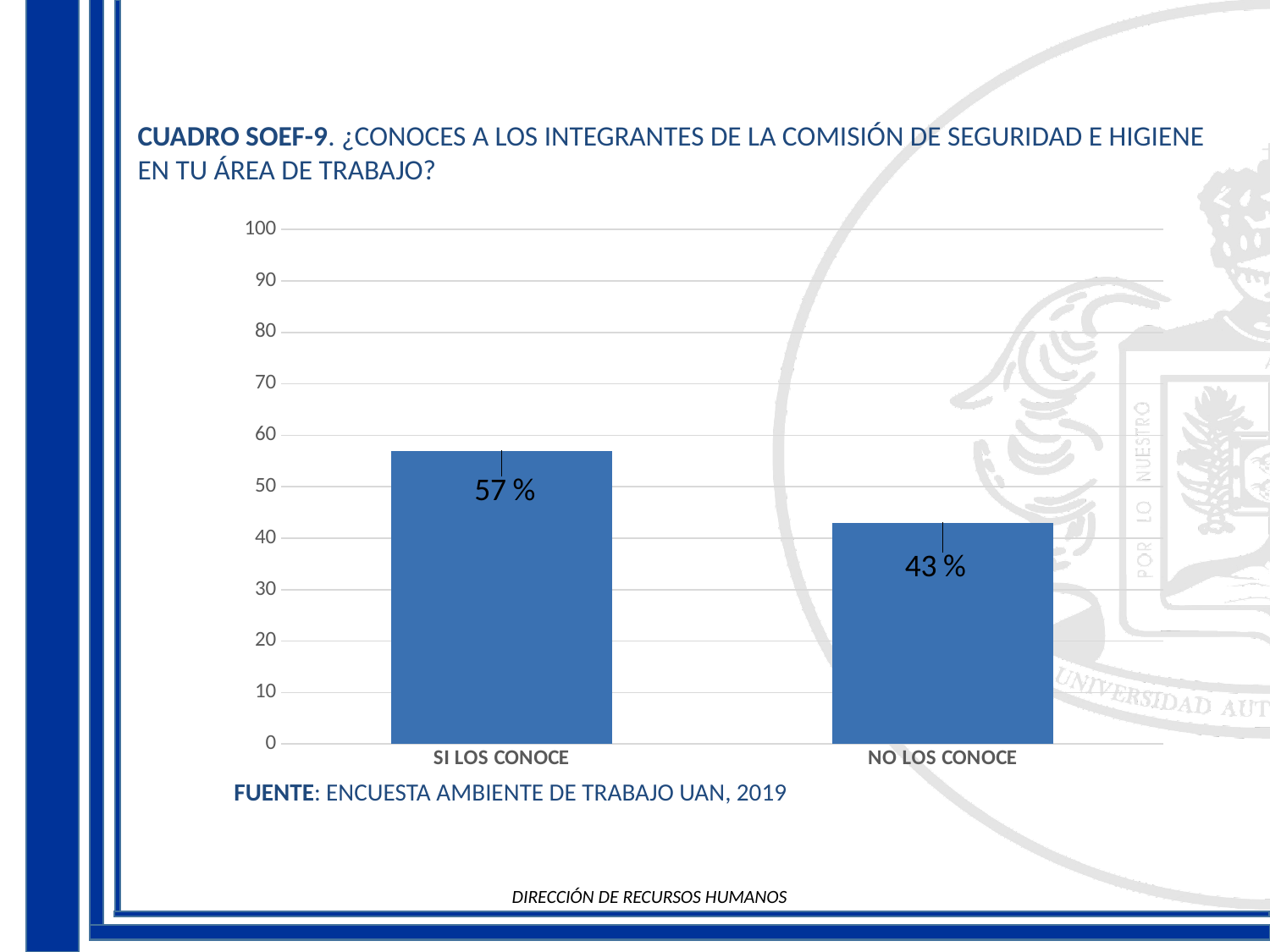
What is the maximum value shown on the vertical axis? 100 Which is larger, the value for SI LOS CONOCE or NO LOS CONOCE? SI LOS CONOCE Which category has the lowest value? NO LOS CONOCE Is the value for SI LOS CONOCE greater or less than 50? greater Is the value for NO LOS CONOCE greater or less than 50? less What source is cited below the chart? ENCUESTA AMBIENTE DE TRABAJO UAN, 2019 What is the value for NO LOS CONOCE? 43 % What is the difference between the values for SI LOS CONOCE and NO LOS CONOCE? 14 % What kind of chart is shown on the slide? bar chart What is the value for SI LOS CONOCE? 57 % How many categories are shown on the x axis? 2 Which category has the highest value? SI LOS CONOCE